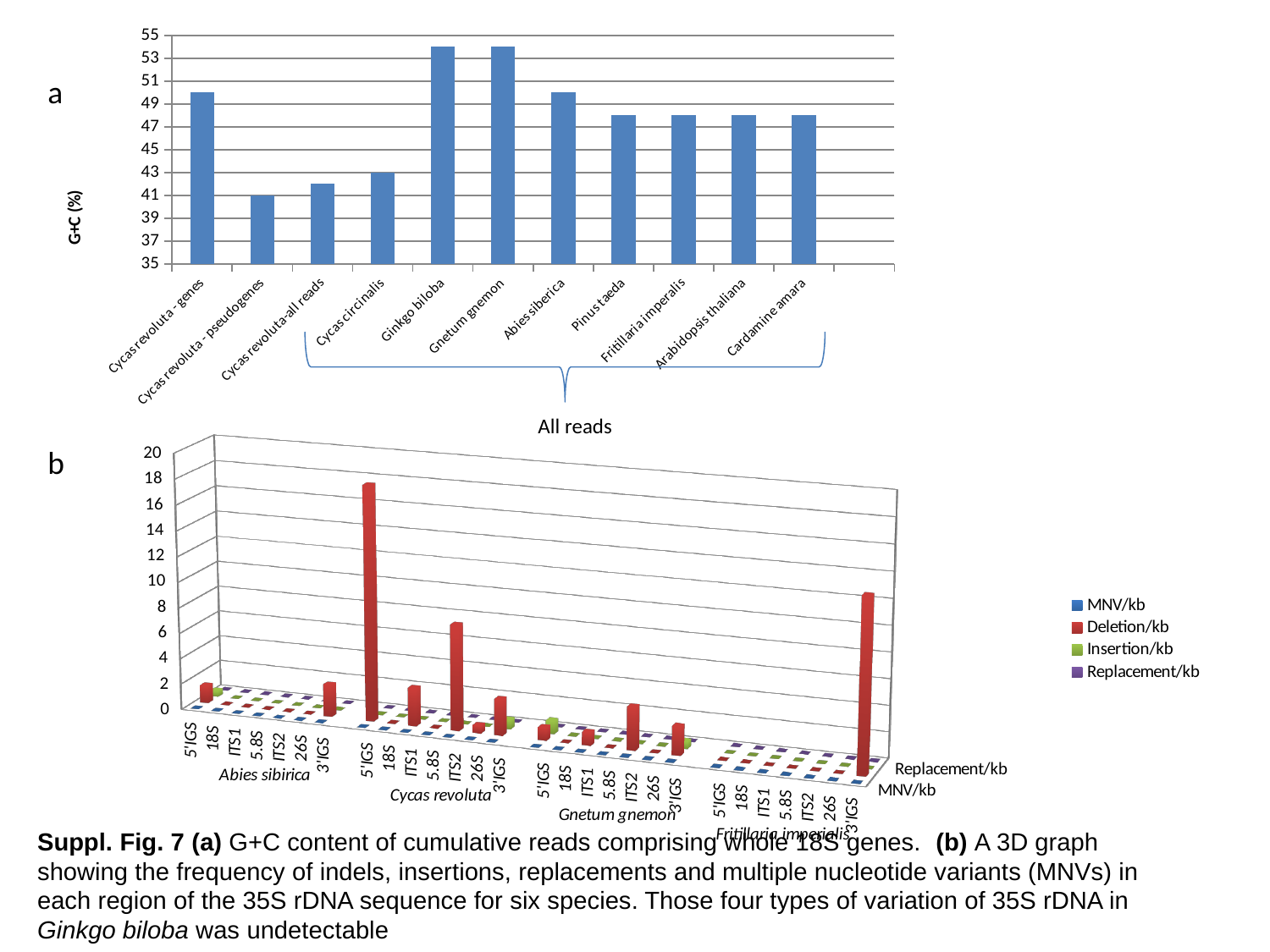
What kind of chart is chart a (the top chart)? bar chart In chart b (the bottom 3D chart), which series is shown in red? Deletion/kb In chart a (the top chart), which is larger: the value for Abies siberica or Pinus taeda? Abies siberica How many categories are shown on the x axis of chart a (the top chart)? 11 How many series does the legend of chart b (the bottom 3D chart) list? 4 In chart a (the top chart), which is larger: the value for Cycas revoluta - genes or Cycas revoluta - pseudogenes? Cycas revoluta - genes In chart a (the top chart), is the value for Ginkgo biloba greater or less than 53? greater In chart a (the top chart), is the value for Cycas circinalis greater or less than 45? less In chart a (the top chart), which category has the lowest G+C (%)? Cycas revoluta - pseudogenes What is the y-axis label of chart a (the top chart)? G+C (%) In chart b (the bottom 3D chart), is the Deletion/kb value for the 5'IGS region of Cycas revoluta greater or less than 14? greater